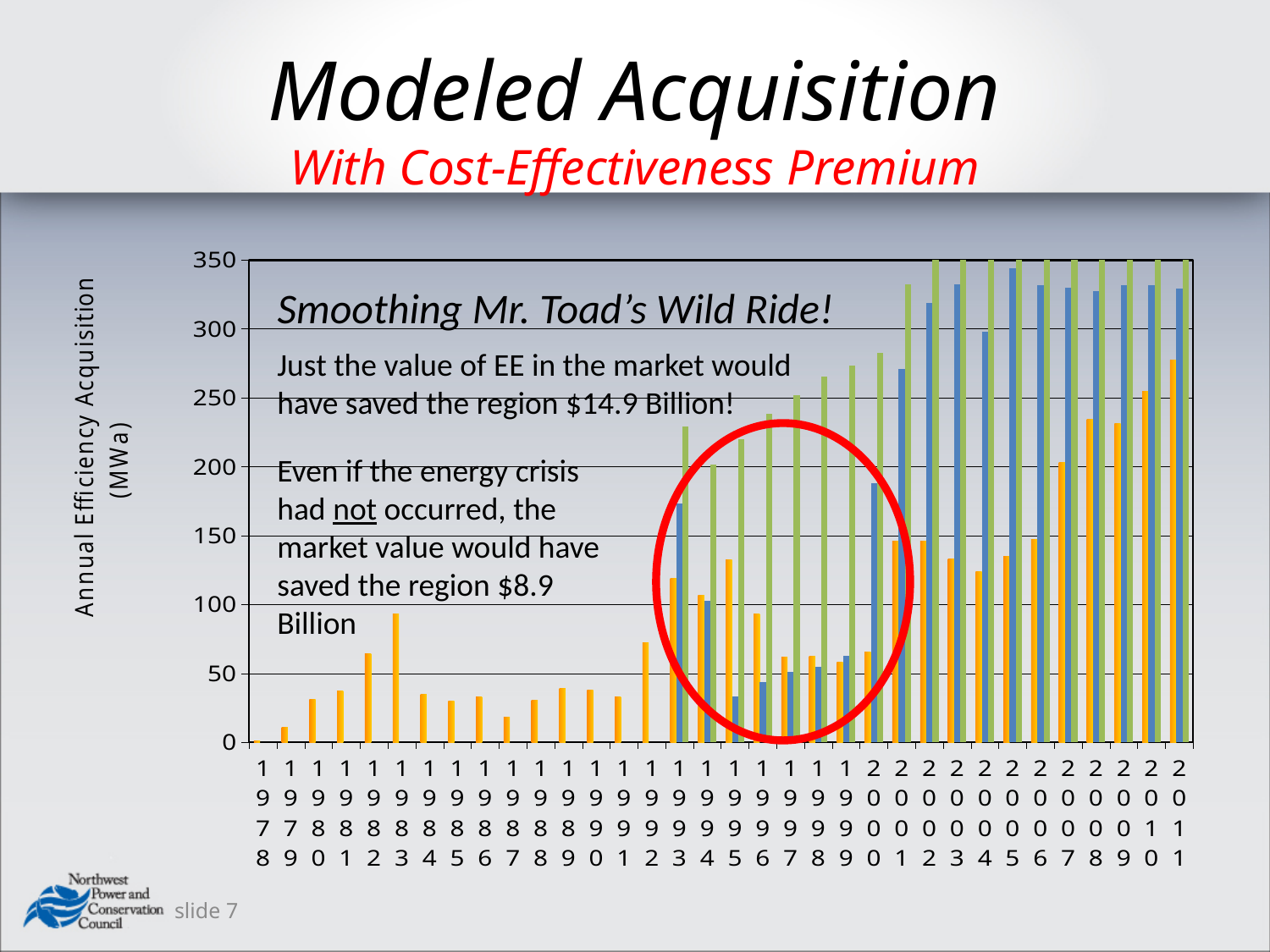
Is the value of the orange bar for 2011 greater or less than 250? greater Which year has the highest orange bar? 2011 Which is larger, the orange bar for 1983 or the orange bar for 1987? 1983 What is the first year shown on the x axis of the chart? 1978 What is the title of the vertical axis of the chart? Annual Efficiency Acquisition (MWa) Is the value of the orange bar for 1987 greater or less than 50? less What kind of chart is shown on the slide? bar chart Is the value of the green bar for 1993 greater or less than 200? greater Do the orange bars generally rise or fall from 2005 to 2011? rise How many years are shown along the x axis of the chart? 34